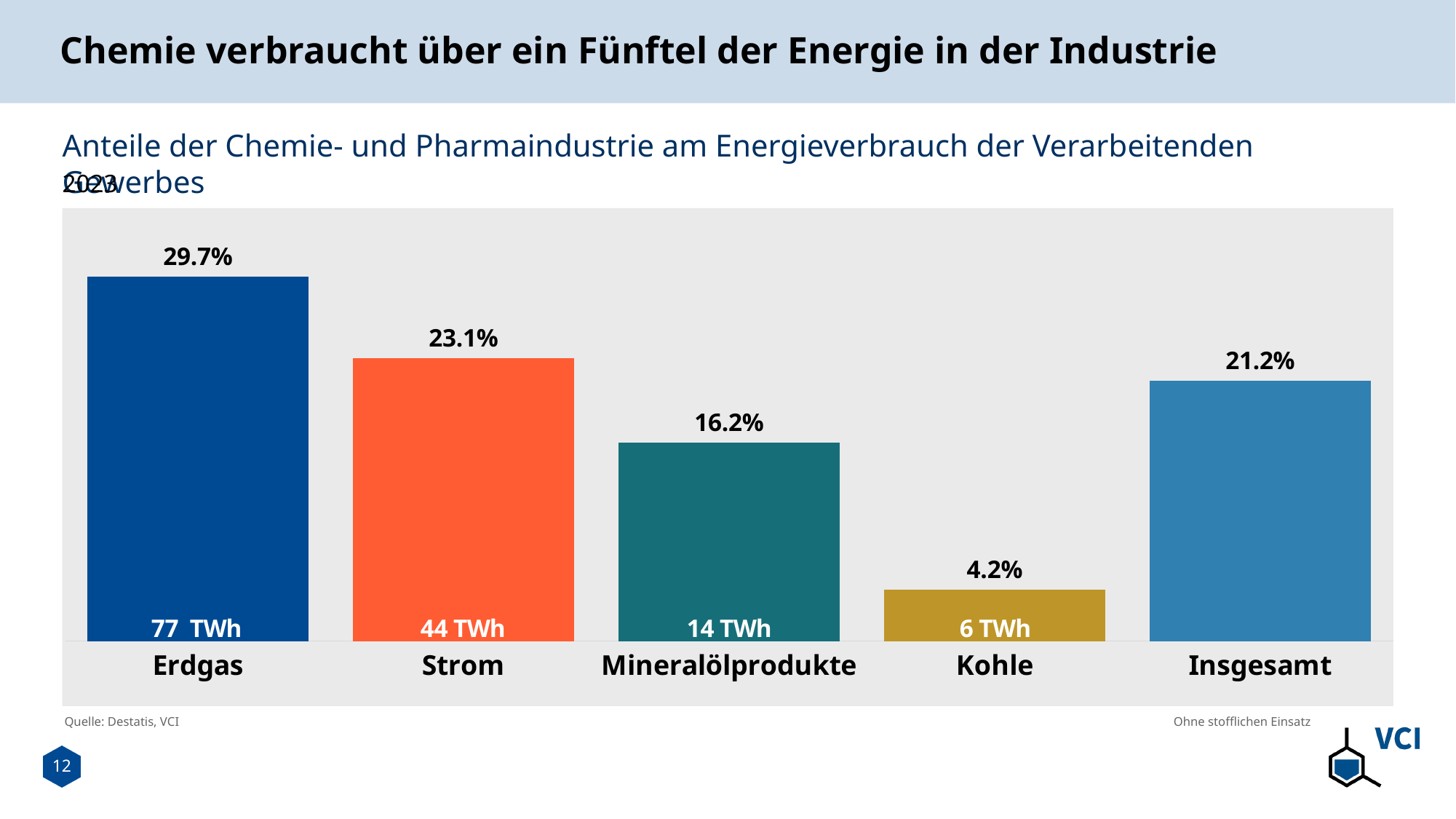
How many categories are shown on the x axis? 5 How many TWh are shown inside the Mineralölprodukte bar? 14 TWh Which has a larger percentage share, Mineralölprodukte or Insgesamt? Insgesamt What is the percentage share shown for Erdgas? 29.7% How many TWh are shown inside the Erdgas bar? 77 TWh What is the percentage share shown for Strom? 23.1% Which category has the highest percentage share? Erdgas What is the difference in percentage points between the Erdgas share and the Strom share? 6.6 What is the percentage share shown for Kohle? 4.2% What source is cited below the chart? Destatis, VCI Which category has the lowest percentage share? Kohle What kind of chart is shown on the slide? Bar chart